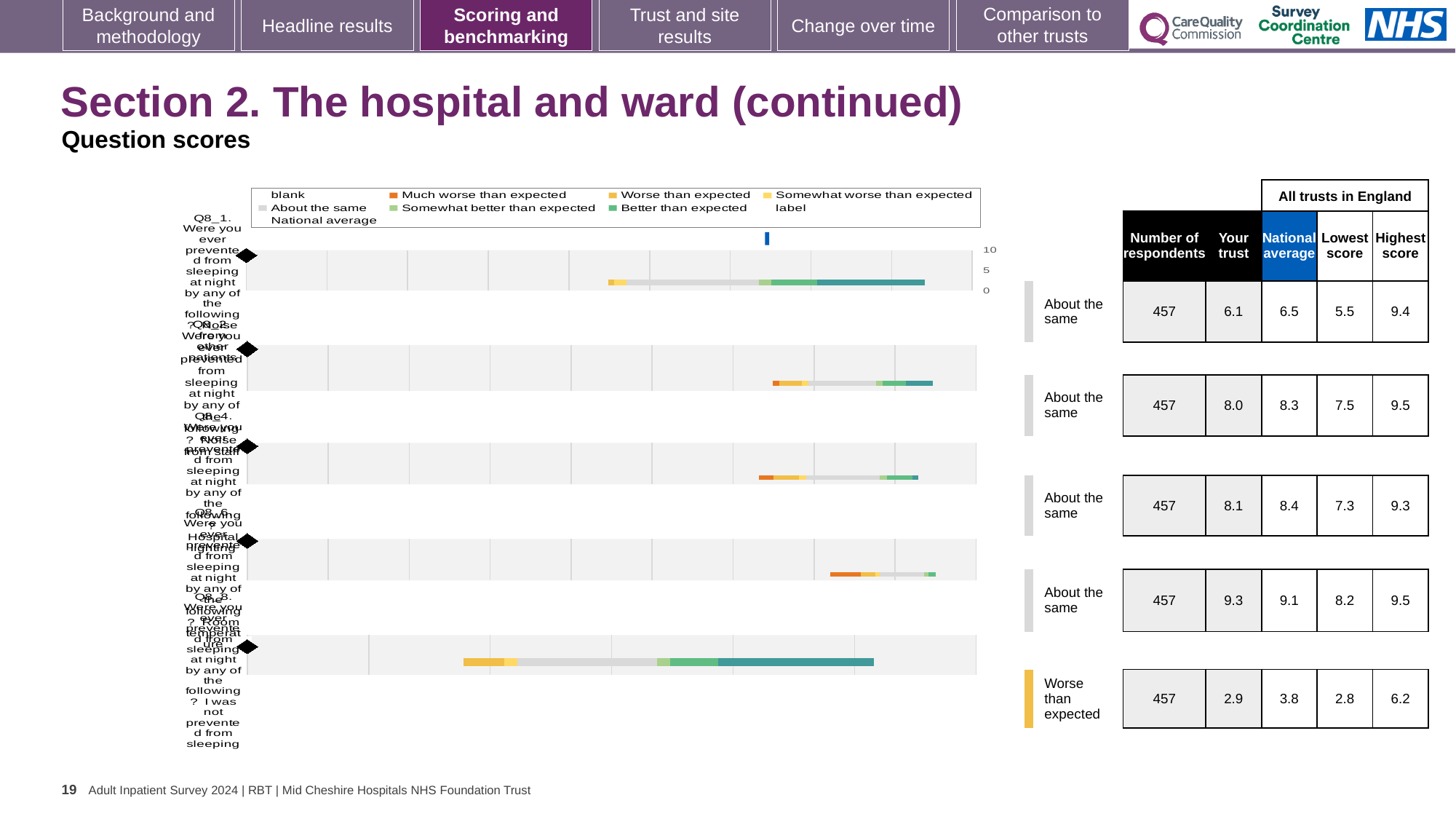
How many question rows (bars) are plotted in the chart? 5 What benchmark label is given to the bottom row (Q8_8)? Worse than expected Which question row has the lowest 'Your trust' score? Q8_8 (bottom row) For the first row (Q8_1), how much higher is the national average than the 'Your trust' score? 0.4 What kind of chart is shown on the slide? bar chart How many respondents are listed for each question row? 457 Which question row has the highest 'Your trust' score? Q8_6 (fourth row) For the fourth row (Q8_6), which is larger: the 'Your trust' score or the national average? Your trust What is the 'Your trust' score for the first row (Q8_1)? 6.1 For the bottom row (Q8_8), what is the difference between the highest score and the lowest score? 3.4 What is the highest score among all trusts in England for the second row (Q8_2)? 9.5 What is the national average for the bottom row (Q8_8)? 3.8